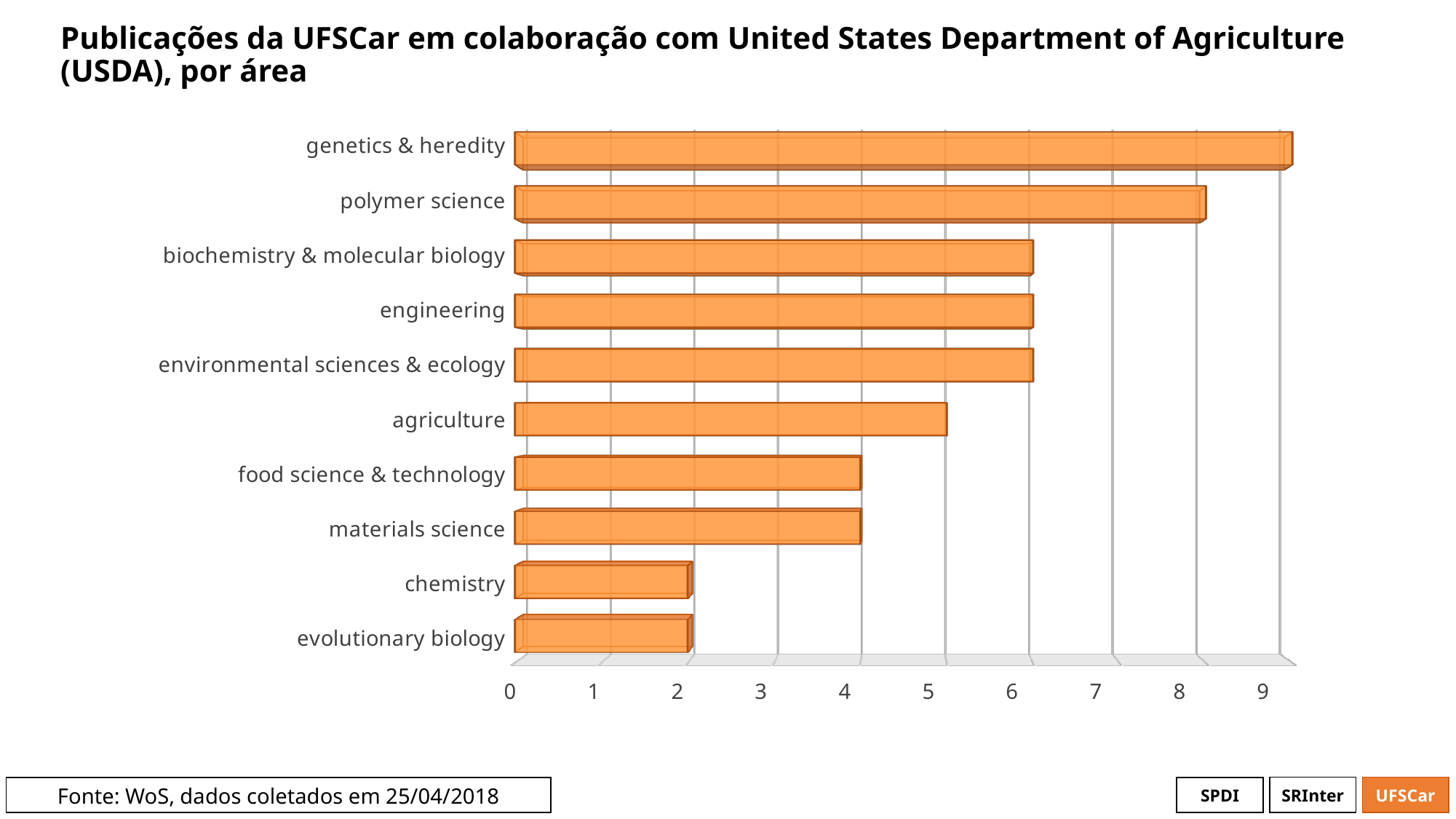
How many publications are shown for agriculture? 5 Is the value for food science & technology greater or less than 5? less How many areas (categories) are shown in the chart? 10 How many publications are shown for engineering? 6 What is the source of the data cited on the slide? WoS, dados coletados em 25/04/2018 What kind of chart is shown on the slide? bar chart How many publications are shown for polymer science? 8 Which area has the highest number of publications? genetics & heredity How many publications are shown for genetics & heredity? 9 Is the value for chemistry greater or less than 3? less Which has more publications, polymer science or agriculture? polymer science Which has more publications, materials science or environmental sciences & ecology? environmental sciences & ecology